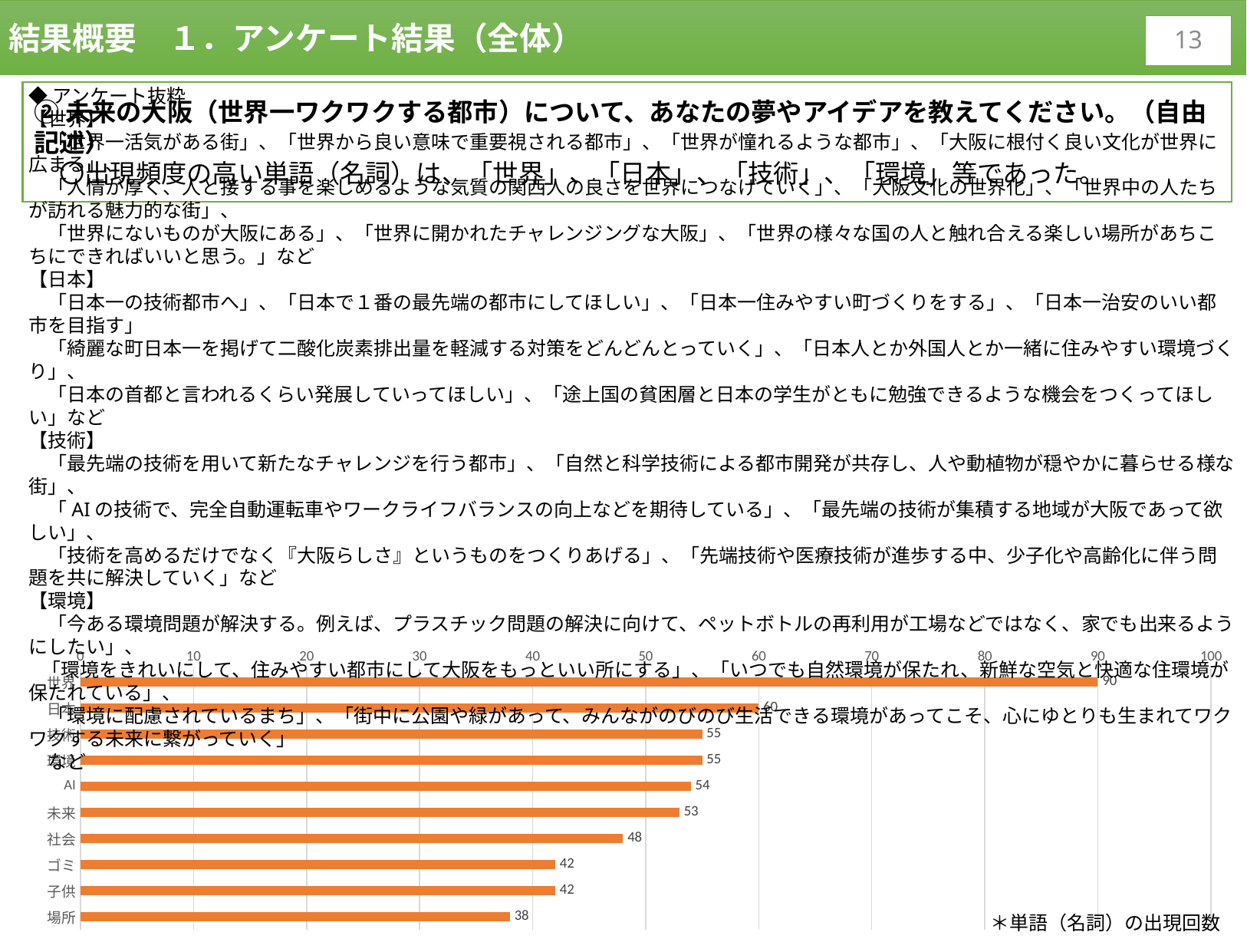
What is the value for AI in the chart? 54 What is the value for 世界 in the chart? 90 How many bars (words) are plotted in the chart? 10 Which word has the highest count in the chart? 世界 What is the difference between the values for 世界 and 場所? 52 Which has a larger value, 社会 or ゴミ? 社会 What colour are the bars in the chart? orange What is the value for 未来 in the chart? 53 Which word has the lowest count in the chart? 場所 Is the value for 子供 greater or less than 50? less What is the value for 場所 in the chart? 38 What kind of chart is shown at the bottom of the slide? bar chart